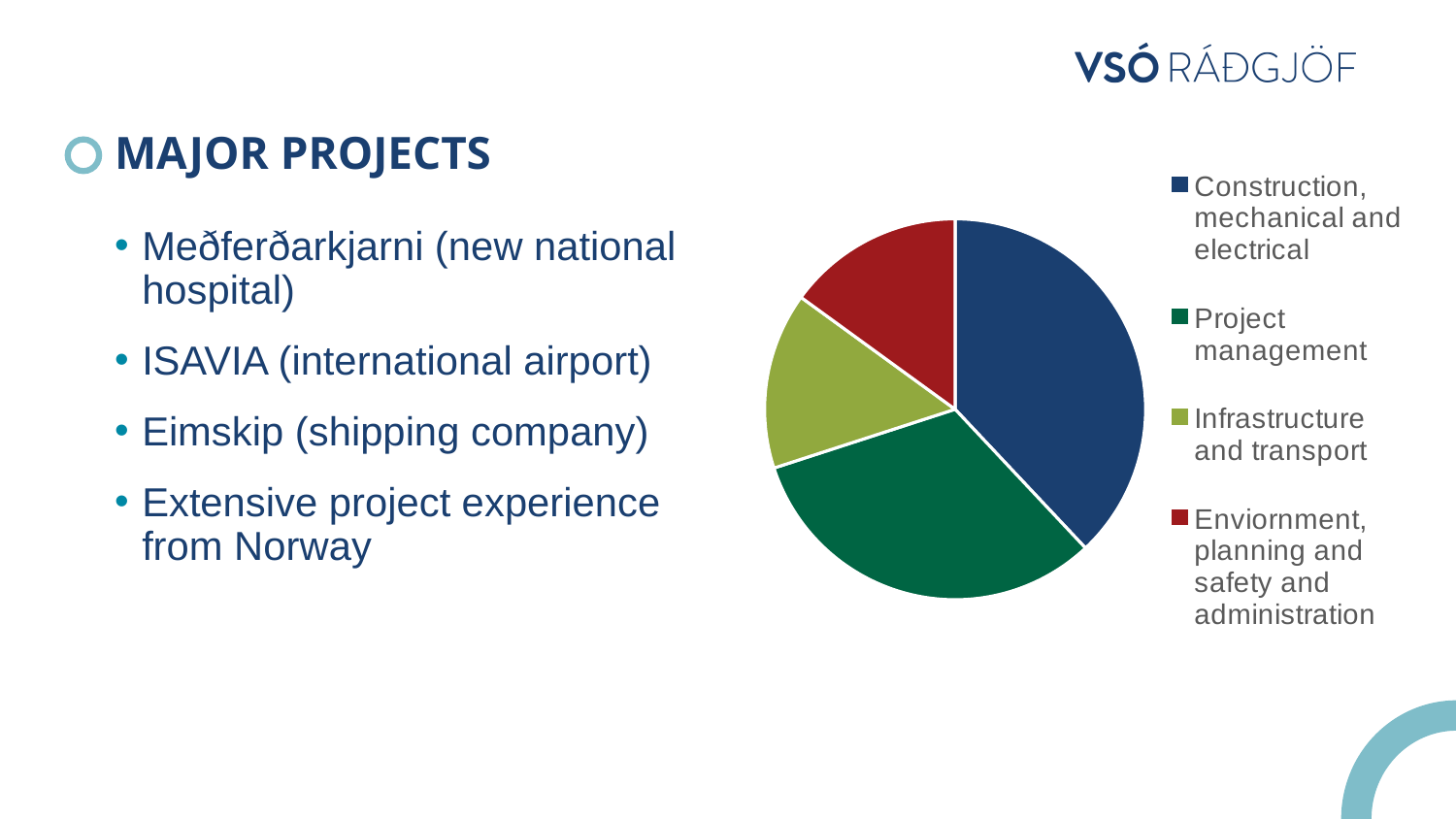
What kind of chart is shown on the slide? Pie chart Which slice is larger: Project management or Enviornment, planning and safety and administration? Project management Which slice is larger: Construction, mechanical and electrical or Enviornment, planning and safety and administration? Construction, mechanical and electrical What colour is the Project management slice in the pie chart? Green How many slices does the pie chart have? 4 How many entries does the legend of the pie chart list? 4 Which slice is larger: Project management or Infrastructure and transport? Project management Which legend entry is shown in red in the pie chart? Enviornment, planning and safety and administration Which category has the largest slice in the pie chart? Construction, mechanical and electrical